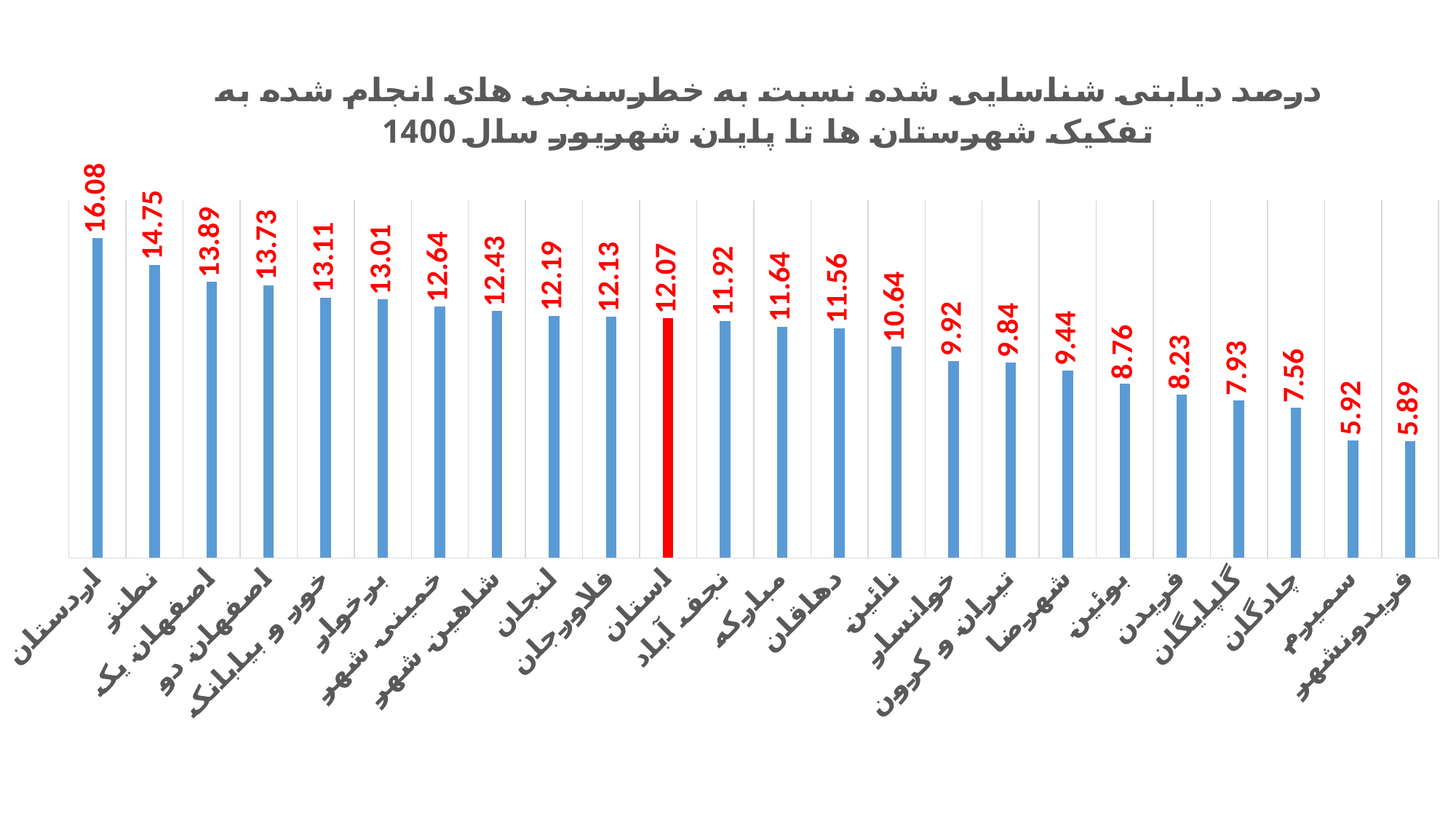
What is the value for اردستان? 16.08 Which is larger, the value for خوانسار or the value for شهرضا? خوانسار What type of chart is shown on the slide? bar chart Which bar is coloured red instead of blue? استان What is the value for گلپایگان? 7.93 What is the difference between the values for نطنز and استان? 2.68 What is the value for نجف آباد? 11.92 What is the difference between the values for اردستان and فریدونشهر? 10.19 What is the value for استان (the red bar)? 12.07 Which category has the lowest value? فریدونشهر How many bars are plotted in the chart? 24 Which category has the highest value? اردستان